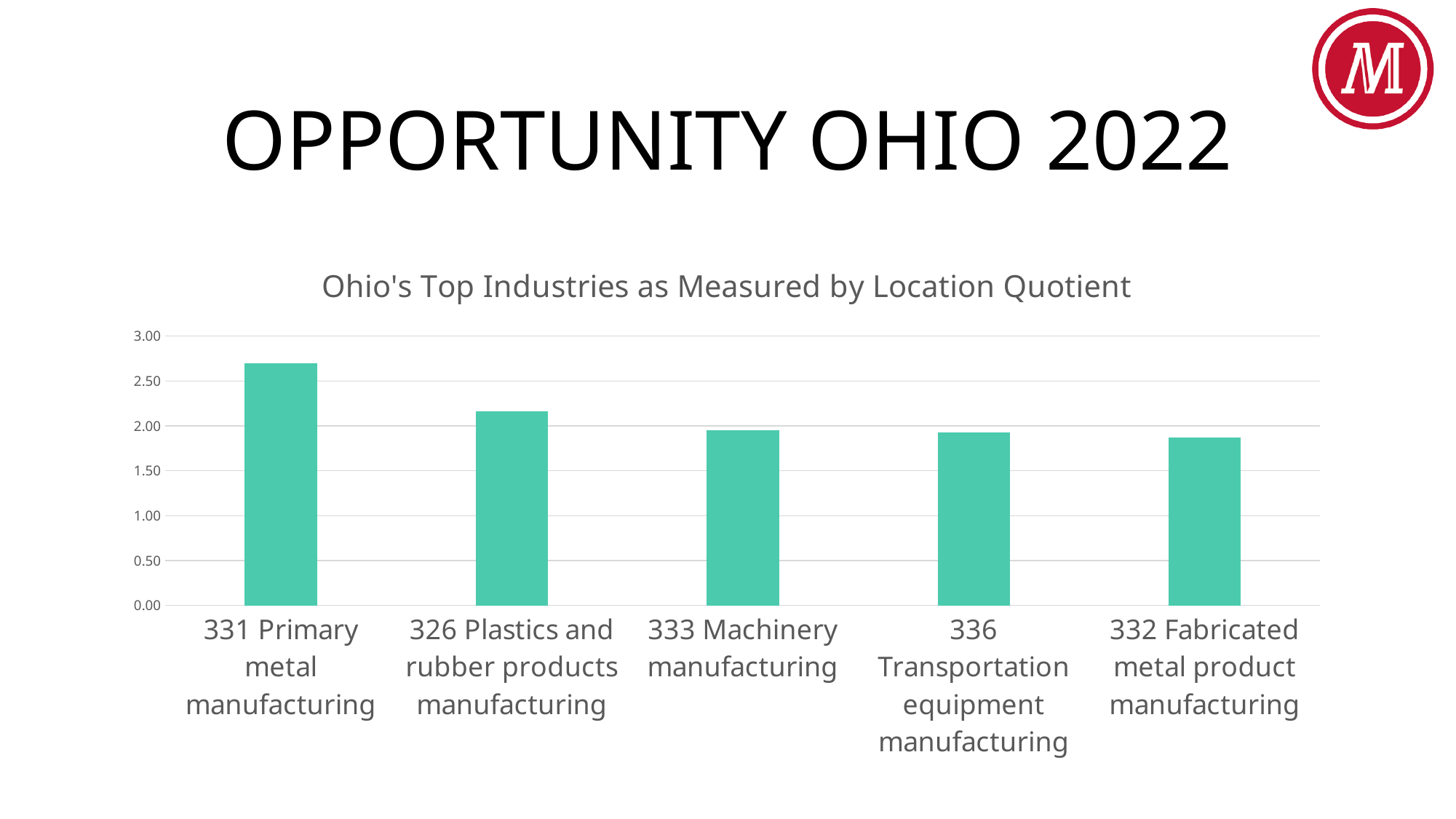
What is the title of the chart? Ohio's Top Industries as Measured by Location Quotient What type of chart is shown on the slide? bar chart How many industries are plotted in the chart? 5 Is the value for 331 Primary metal manufacturing greater or less than 2.50? greater Is the value for 336 Transportation equipment manufacturing greater or less than 1.50? greater What is the highest value shown on the vertical axis? 3.00 Is the value for 332 Fabricated metal product manufacturing greater or less than 2.00? less Do the bar values rise or fall from left to right across the chart? fall Which has a larger location quotient, 331 Primary metal manufacturing or 326 Plastics and rubber products manufacturing? 331 Primary metal manufacturing Which has a larger location quotient, 326 Plastics and rubber products manufacturing or 333 Machinery manufacturing? 326 Plastics and rubber products manufacturing Which industry has the highest location quotient? 331 Primary metal manufacturing